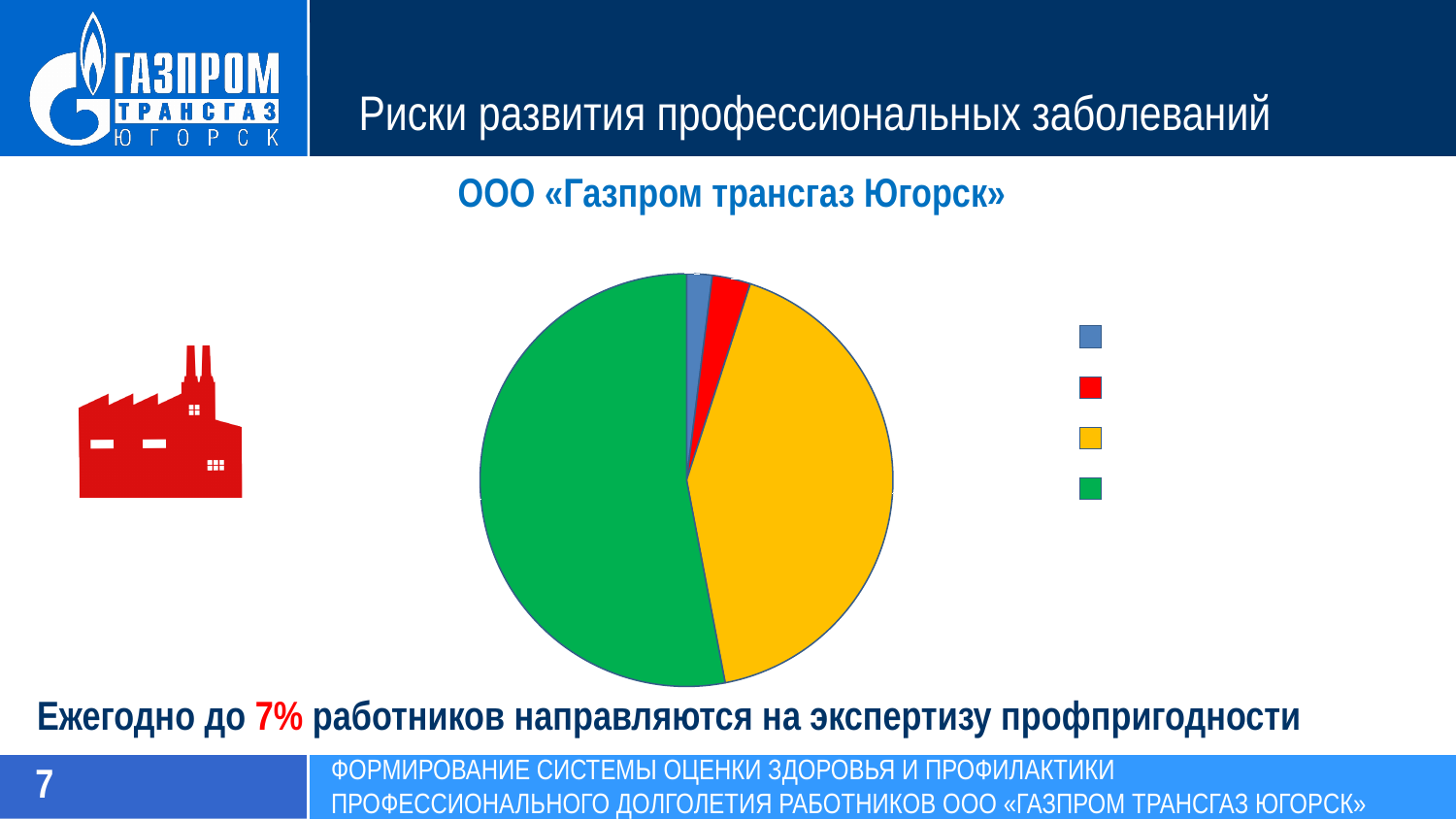
Which is larger in the pie chart, the green slice or the blue slice? the green slice Which is larger in the pie chart, the yellow slice or the blue slice? the yellow slice How many entries does the legend of the pie chart list? 4 What title appears above the pie chart? ООО «Газпром трансгаз Югорск» Which slice of the pie chart is the largest? the green slice What colours are used for the four slices of the pie chart? blue, red, yellow and green Which is larger in the pie chart, the yellow slice or the red slice? the yellow slice How many slices does the pie chart have? 4 What kind of chart is shown on the slide? pie chart